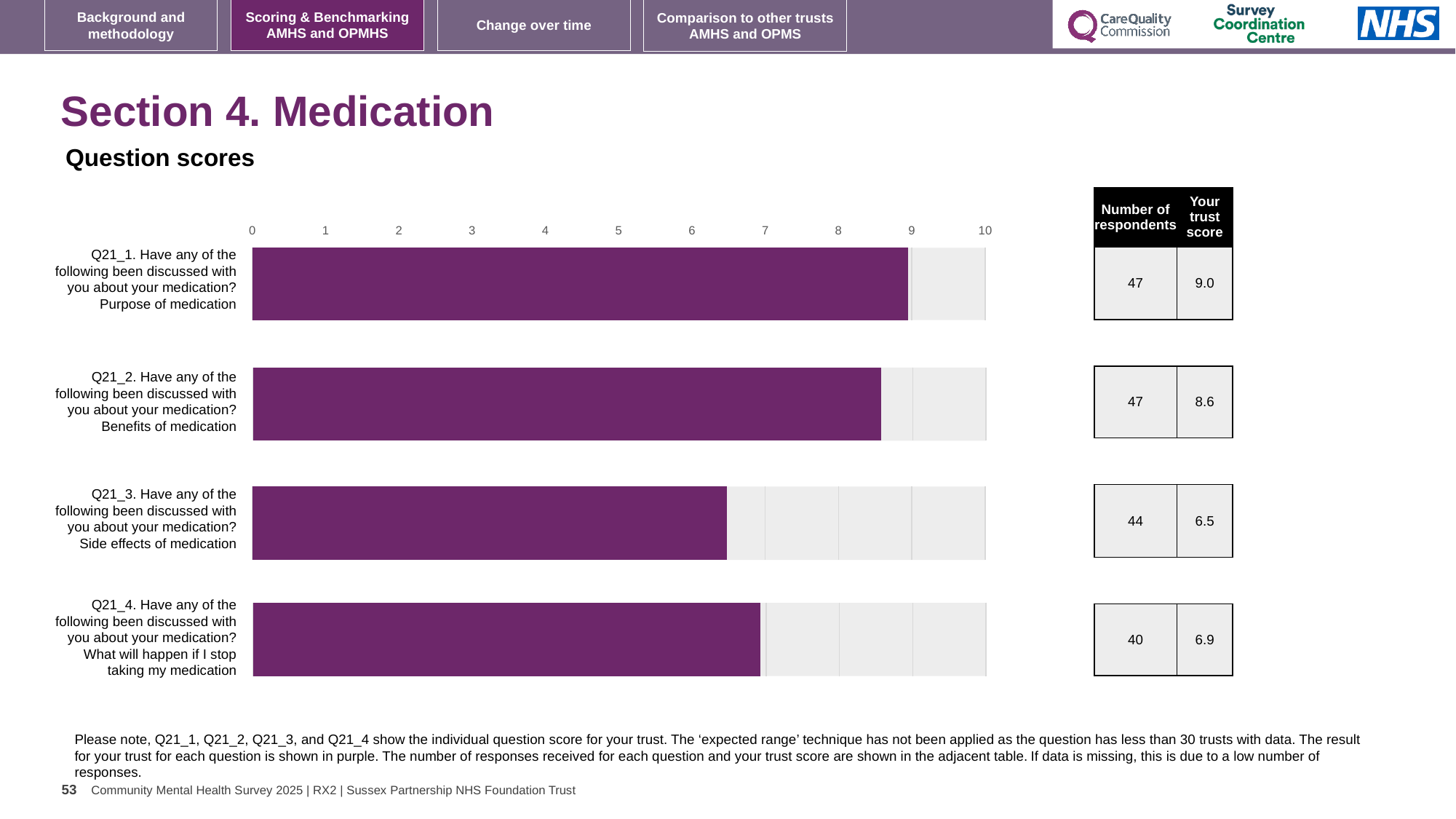
How many respondents answered Q21_2 (Benefits of medication)? 47 How many questions are plotted in the chart? 4 Is the bar for Q21_2 (Benefits of medication) greater or less than 8 on the axis? greater What is the trust score for Q21_1 (Purpose of medication)? 9.0 What is the trust score for Q21_3 (Side effects of medication)? 6.5 Which has the larger trust score, Q21_3 (Side effects of medication) or Q21_4 (What will happen if I stop taking my medication)? Q21_4. What will happen if I stop taking my medication What is the difference between the trust scores for Q21_1 (Purpose of medication) and Q21_2 (Benefits of medication)? 0.4 What is the maximum value shown on the chart's axis? 10 What is the trust score for Q21_4 (What will happen if I stop taking my medication)? 6.9 Which question has the highest trust score? Q21_1. Purpose of medication Which question has the lowest trust score? Q21_3. Side effects of medication What type of chart is shown on the slide? bar chart